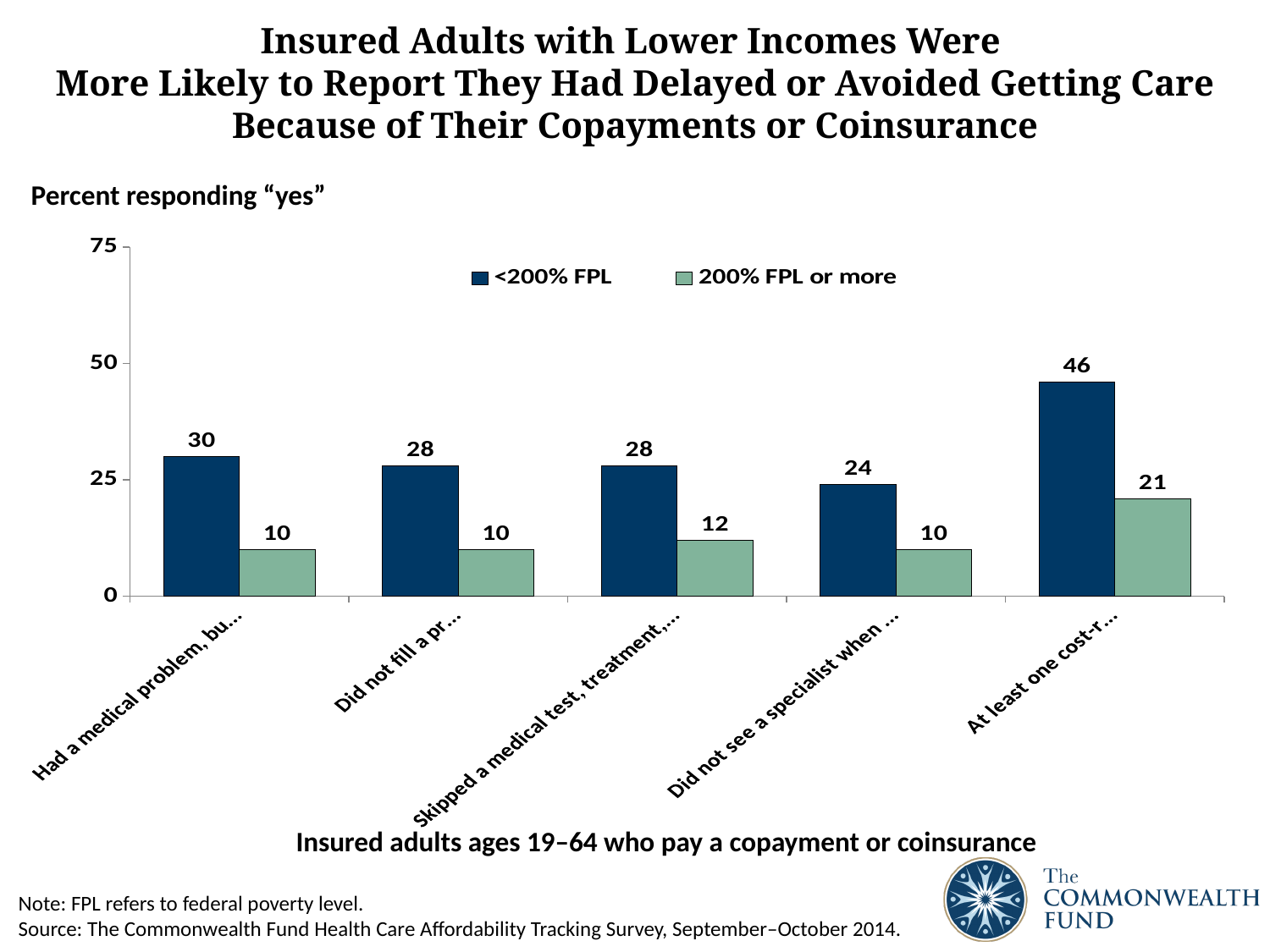
What is the value for 200% FPL or more in the first category, "Had a medical problem, bu..."? 10 Which category has the highest value for the <200% FPL series? At least one cost-r... (the rightmost category) How many series does the legend list? 2 What is the difference between the <200% FPL and 200% FPL or more values in the rightmost category, "At least one cost-r..."? 25 What kind of chart is shown on the slide? Bar chart What is the value for <200% FPL in the category labeled "At least one cost-r..." (the rightmost category)? 46 How many categories are shown on the x axis? 5 What is the value for <200% FPL in the category labeled "Did not see a specialist when ..."? 24 Which category has the lowest value for the <200% FPL series? Did not see a specialist when ... What is the value for 200% FPL or more in the category labeled "Skipped a medical test, treatment,..."? 12 What are the two series named in the legend? <200% FPL and 200% FPL or more In the category "Did not fill a pr...", which series has the larger value, <200% FPL or 200% FPL or more? <200% FPL